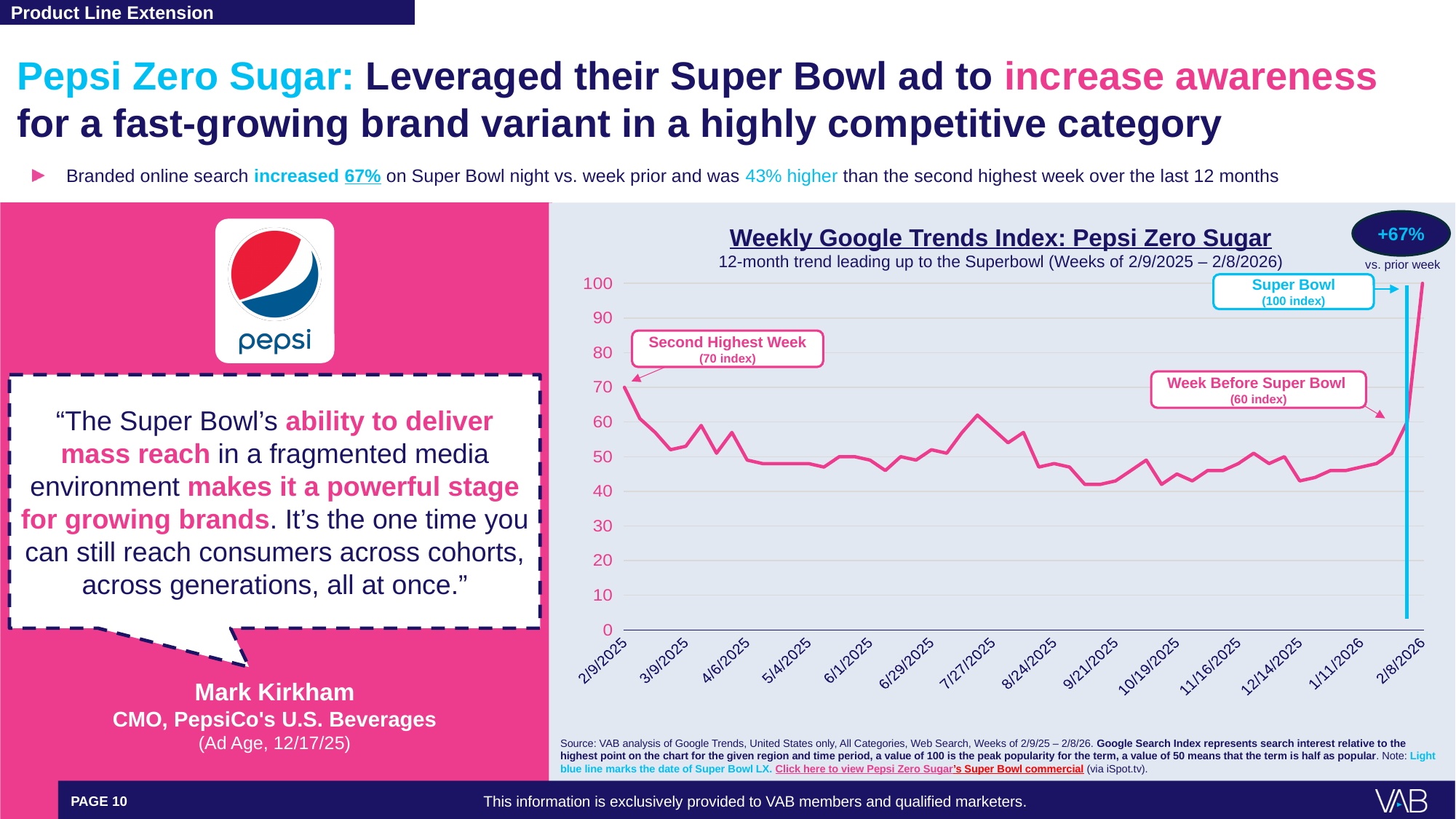
Which is larger: the Second Highest Week index or the Week Before Super Bowl index? Second Highest Week What is the difference between the Super Bowl week index and the Week Before Super Bowl index? 40 What kind of chart is used to show the Weekly Google Trends Index? Line chart What percentage change vs. the prior week is shown in the callout next to the chart? +67% What index value is labeled for the Week Before Super Bowl? 60 What index value is labeled for the Second Highest Week? 70 How many date labels are shown on the x axis of the chart? 14 Is the index value for the week of 9/21/2025 greater or less than 50? less What is the index value for the Super Bowl week in the Weekly Google Trends Index chart? 100 What is the difference between the Super Bowl week index and the Second Highest Week index? 30 Which week has the highest Google Trends index on the chart? Super Bowl week (2/8/2026) Does the index rise or fall between 1/11/2026 and 2/8/2026? Rise